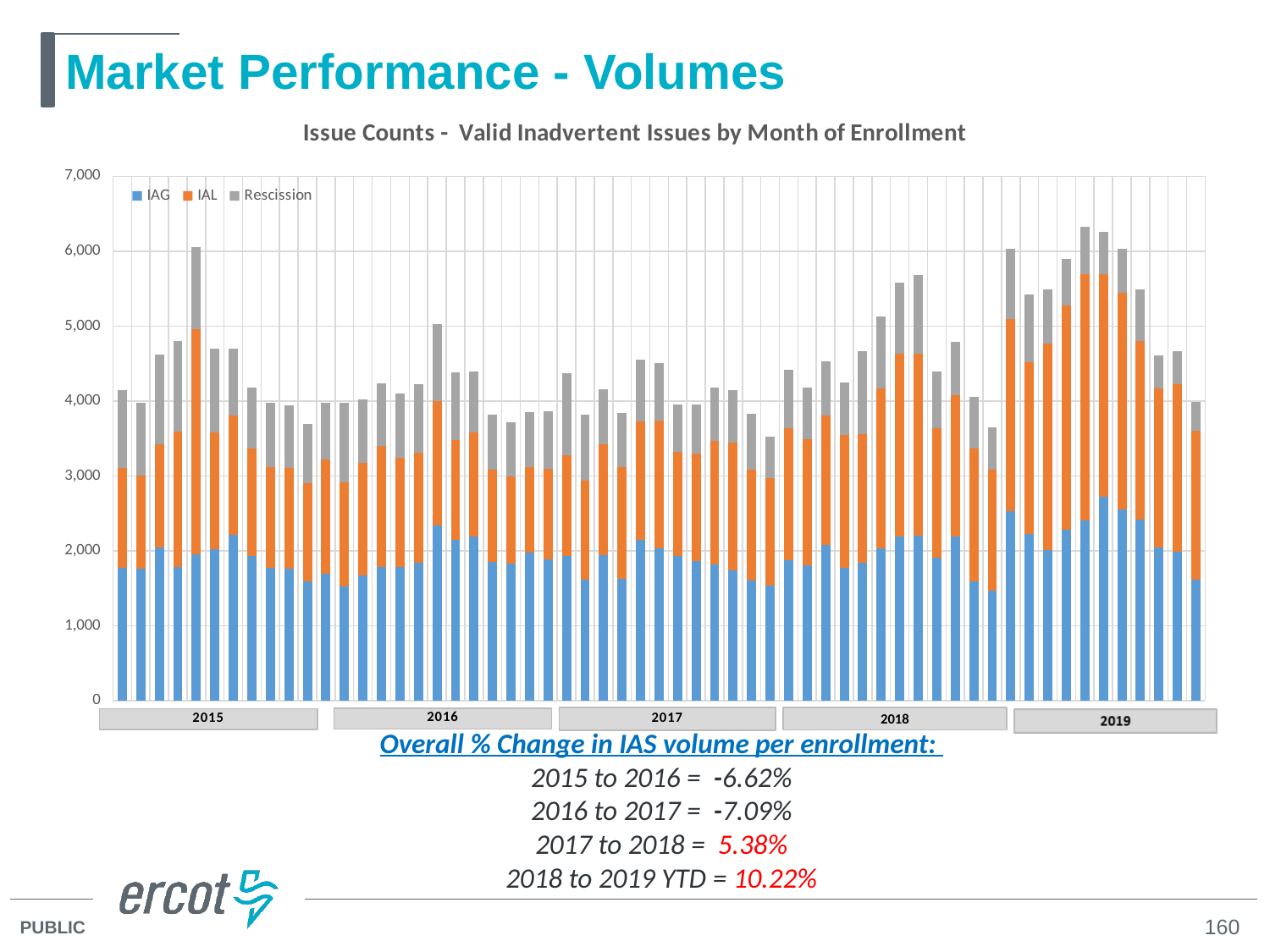
Which series is shown in gray in the legend? Rescission Is the total of the first bar in the 2015 group greater or less than 5,000? less Which series forms the bottom segment of each stacked bar? IAG Is the IAG segment of the tallest bar in the 2019 group greater or less than 2,000? greater What kind of chart is shown on the slide? Stacked bar chart How many series does the legend list? 3 Is the total of the tallest bar in the 2015 group greater or less than 5,000? greater How many year groups are labelled along the x axis? 5 What is the title of the chart? Issue Counts - Valid Inadvertent Issues by Month of Enrollment Which year group contains the tallest bar on the chart? 2019